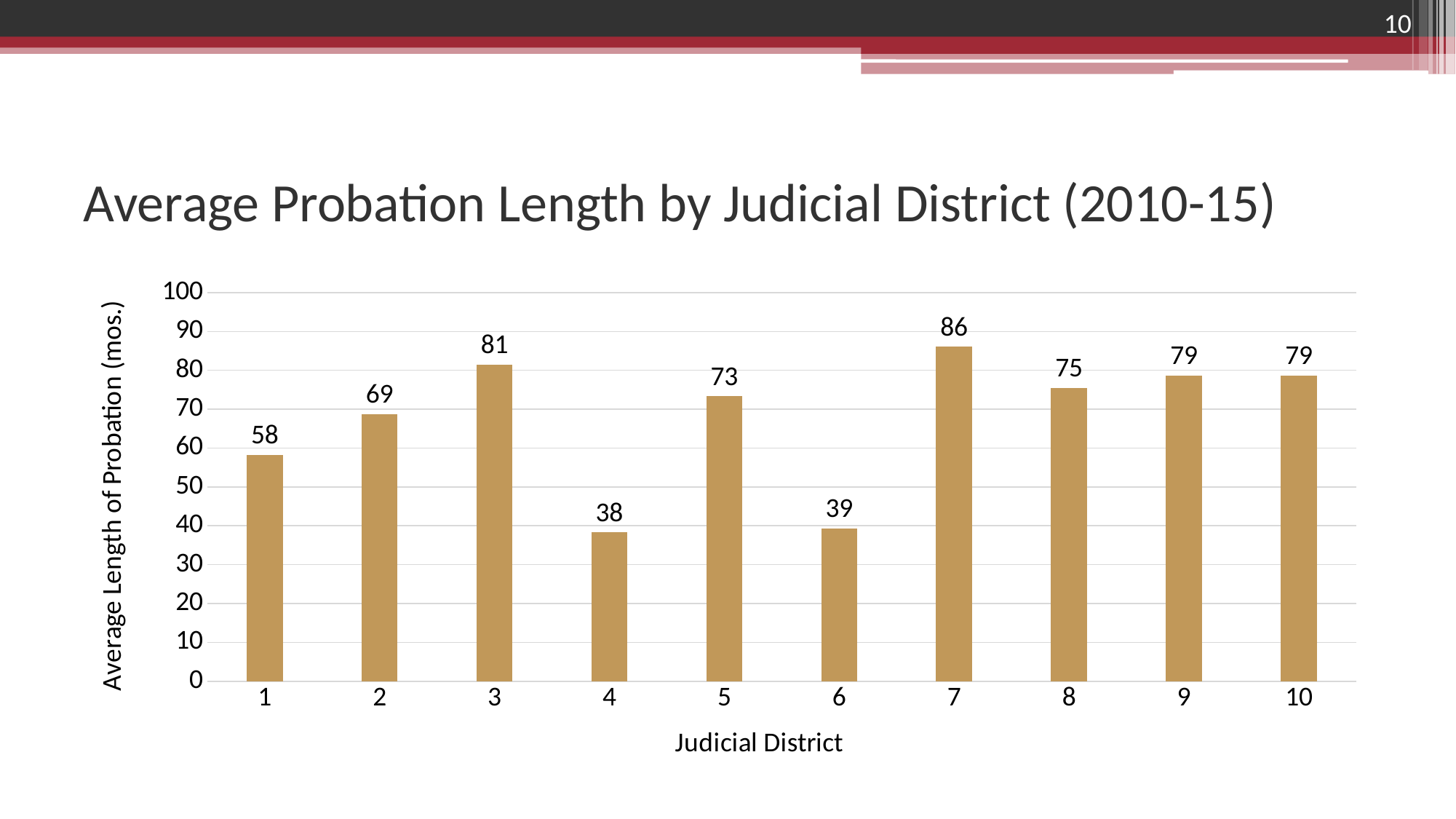
What is the difference in average probation length between Judicial District 7 and Judicial District 4? 48 Which has a longer average probation length, Judicial District 5 or Judicial District 8? Judicial District 8 What is the average probation length for Judicial District 7? 86 What is the average probation length for Judicial District 4? 38 What is the label of the y axis? Average Length of Probation (mos.) Which judicial district has the lowest average probation length? 4 Which judicial district has the highest average probation length? 7 What kind of chart is shown on the slide? Bar chart Is the average probation length for Judicial District 6 greater or less than 50? less What is the average probation length for Judicial District 2? 69 How many judicial districts are shown on the chart? 10 What is the difference in average probation length between Judicial District 3 and Judicial District 1? 23